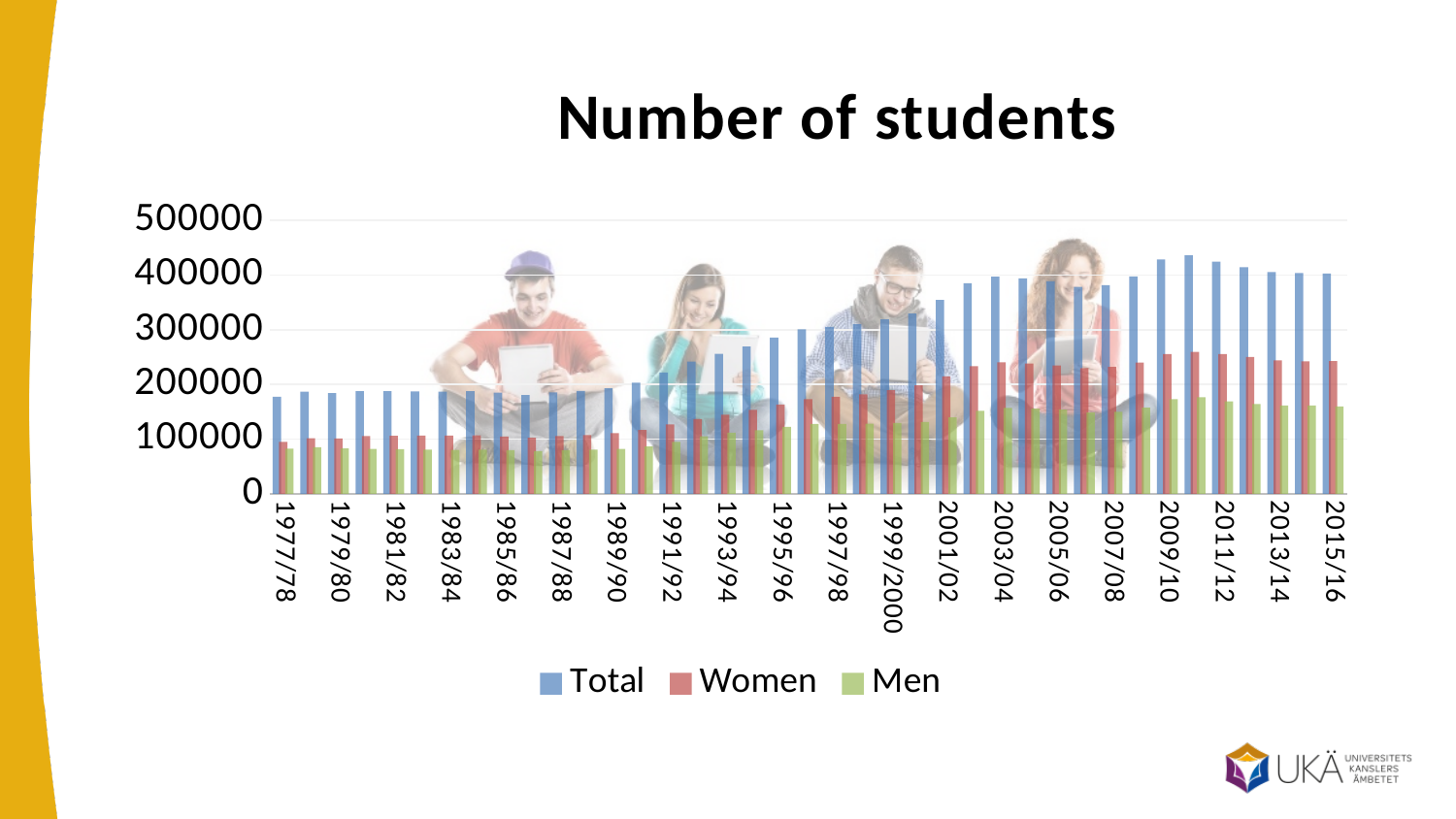
Is the value for Total in 1977/78 greater or less than 200000? less Is the value for Total in 1995/96 greater or less than 300000? less Is the value for Total in 2009/10 greater or less than 400000? greater What is the title of the chart? Number of students In 2015/16, which is larger, the value for Women or the value for Men? Women Does the Total number of students generally rise or fall from 1977/78 to 2015/16? rise How many series does the legend list? 3 What kind of chart is shown on the slide? bar chart Which series is shown in green in the legend? Men